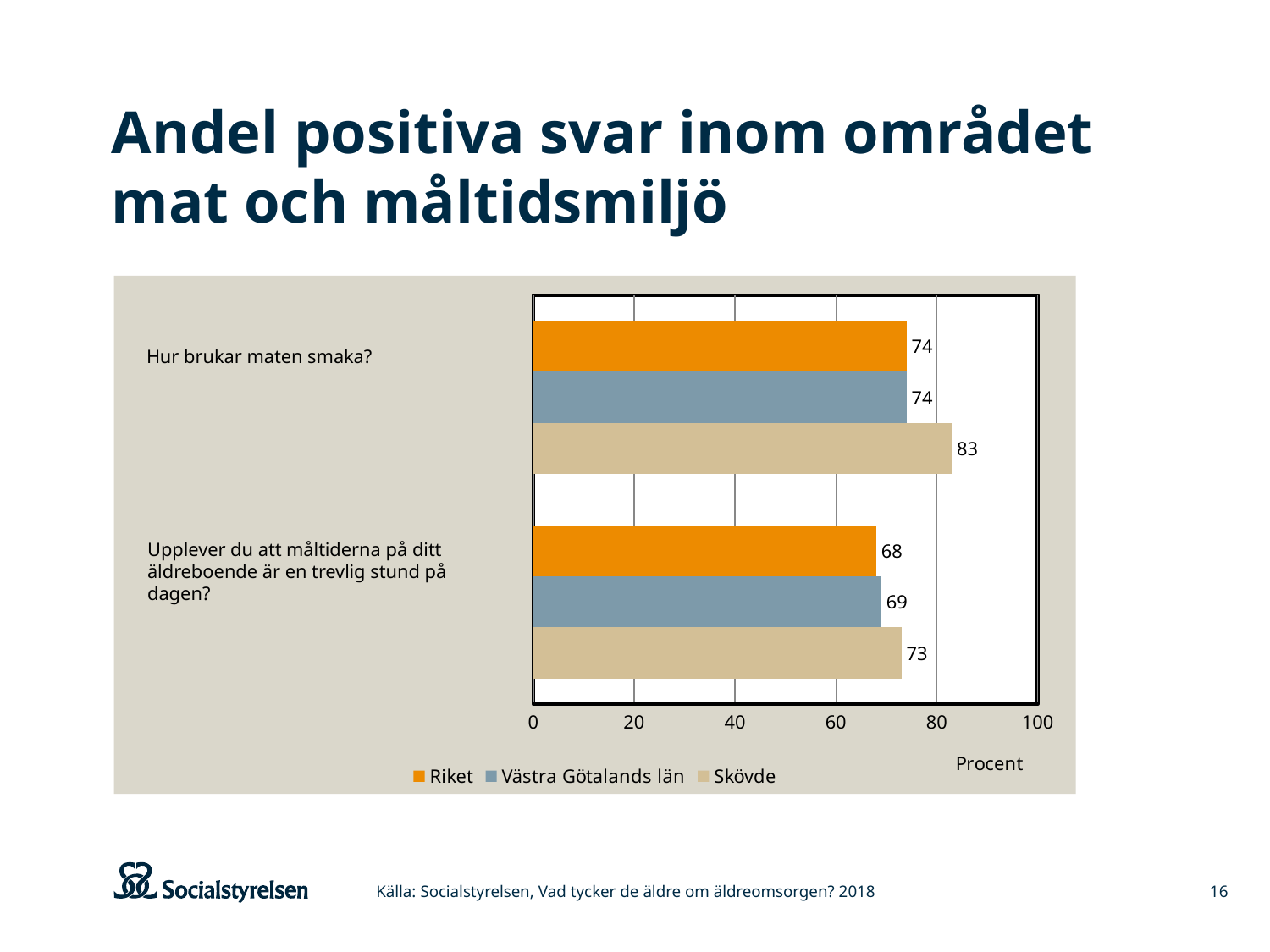
What kind of chart is shown on the slide? bar chart What is the label of the x axis? Procent Which series has the lowest value on "Upplever du att måltiderna på ditt äldreboende är en trevlig stund på dagen?"? Riket What is the difference between the Skövde and Riket values on "Hur brukar maten smaka?"? 9 What is the value for Skövde on "Hur brukar maten smaka?"? 83 What is the value for Västra Götalands län on "Hur brukar maten smaka?"? 74 How many questions (categories) are shown on the chart? 2 How many series does the legend list? 3 What is the value for Riket on "Upplever du att måltiderna på ditt äldreboende är en trevlig stund på dagen?"? 68 Is the value for Skövde on "Hur brukar maten smaka?" greater or less than 80? greater Which series has the highest value on "Upplever du att måltiderna på ditt äldreboende är en trevlig stund på dagen?"? Skövde Which is larger: the Skövde value for "Hur brukar maten smaka?" or the Skövde value for "Upplever du att måltiderna på ditt äldreboende är en trevlig stund på dagen?"? Hur brukar maten smaka?